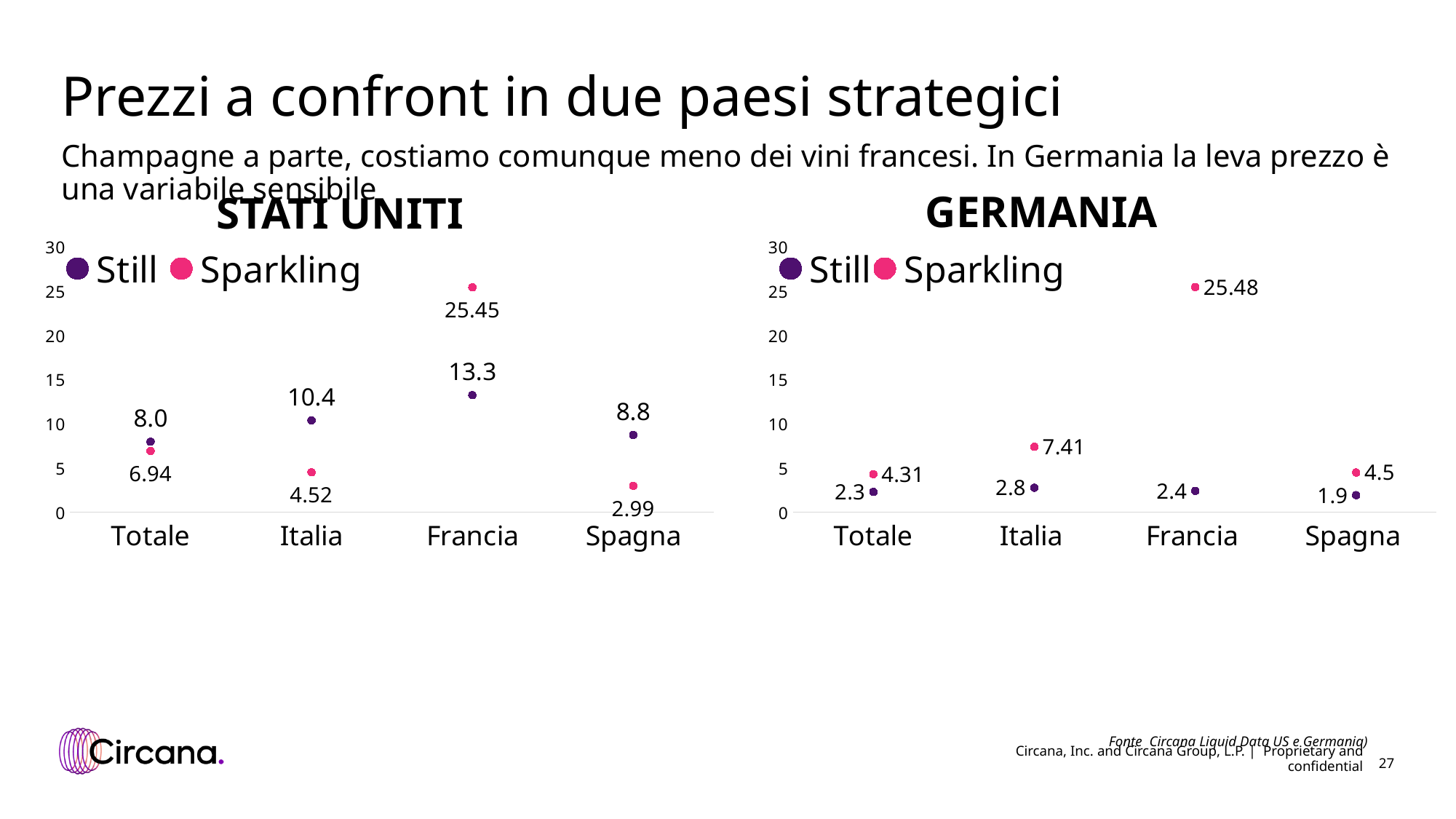
How many series does the legend of the STATI UNITI chart list? 2 In the STATI UNITI chart, which category has the highest Sparkling value? Francia In the STATI UNITI chart, what is the difference between the Still values for Francia and Italia? 2.9 In the GERMANIA chart, what is the difference between the Sparkling and Still values for Totale? 2.01 In the GERMANIA chart, which category has the lowest Still value? Spagna In the STATI UNITI chart, what is the Still value for Francia? 13.3 In the GERMANIA chart, what is the Still value for Spagna? 1.9 In the STATI UNITI chart, which is larger for Spagna: the Still value or the Sparkling value? Still How many categories are shown on the x axis of the GERMANIA chart? 4 In the GERMANIA chart, what is the Sparkling value for Italia? 7.41 In the STATI UNITI chart, what is the Sparkling value for Italia? 4.52 In the GERMANIA chart, is the Sparkling value for Francia greater or less than 20? greater